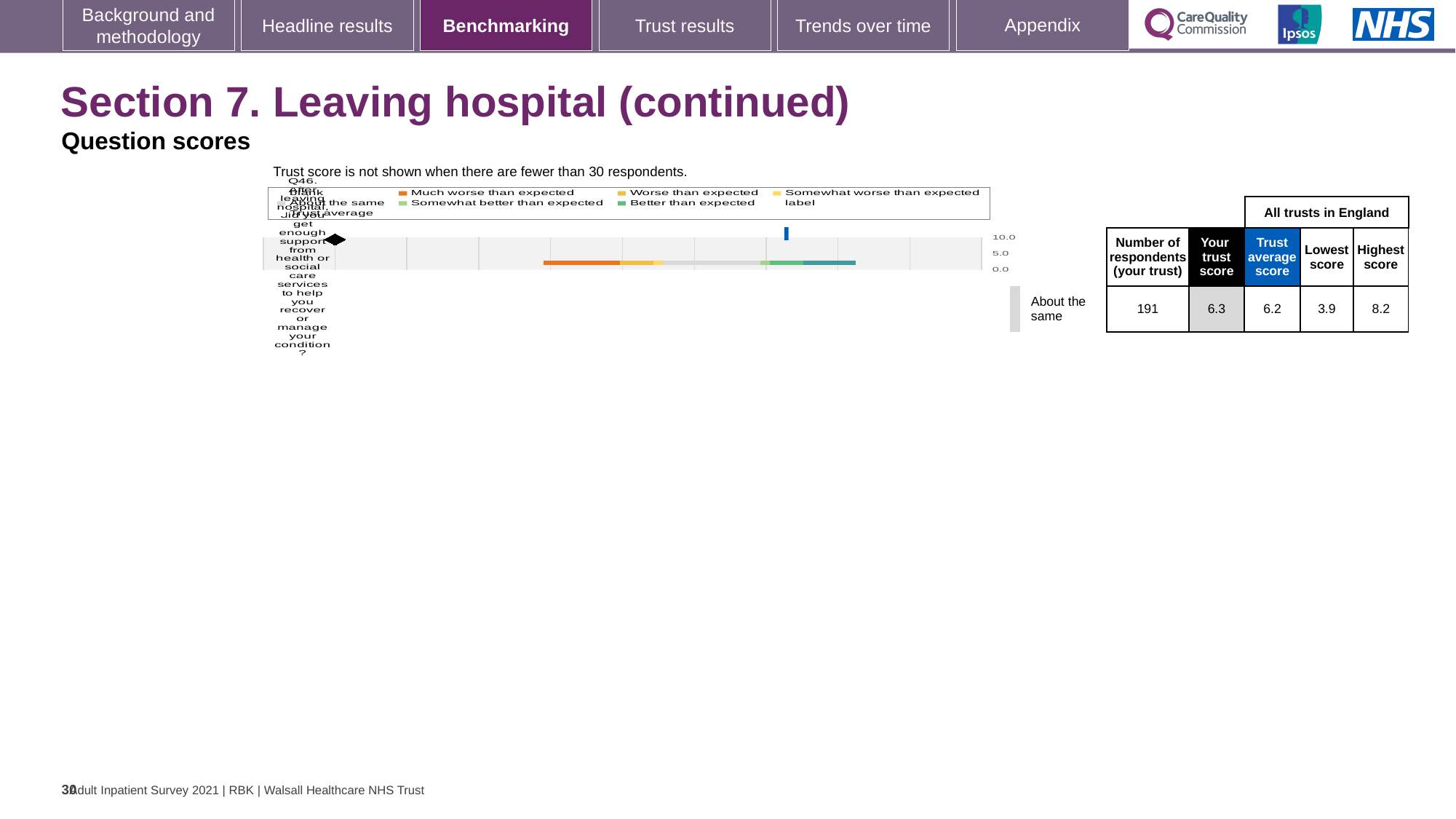
What is the trust average score across all trusts in England for Q46? 6.2 What is the trust score for Q46 (support from health or social care services after leaving hospital)? 6.3 How many questions are plotted on the chart on this slide? 1 How many respondents from the trust answered Q46? 191 What benchmark rating is shown for the trust on Q46? About the same What is the highest score among all trusts in England for Q46? 8.2 What kind of chart is used to show the Q46 benchmarking result? Bar chart Which is larger for Q46: the trust's own score or the trust average score? The trust's own score (6.3) What is the maximum value shown on the chart's score axis? 10.0 By how much does the trust's score for Q46 differ from the trust average score? 0.1 What is the difference between the highest score and the lowest score for Q46? 4.3 What is the lowest score among all trusts in England for Q46? 3.9